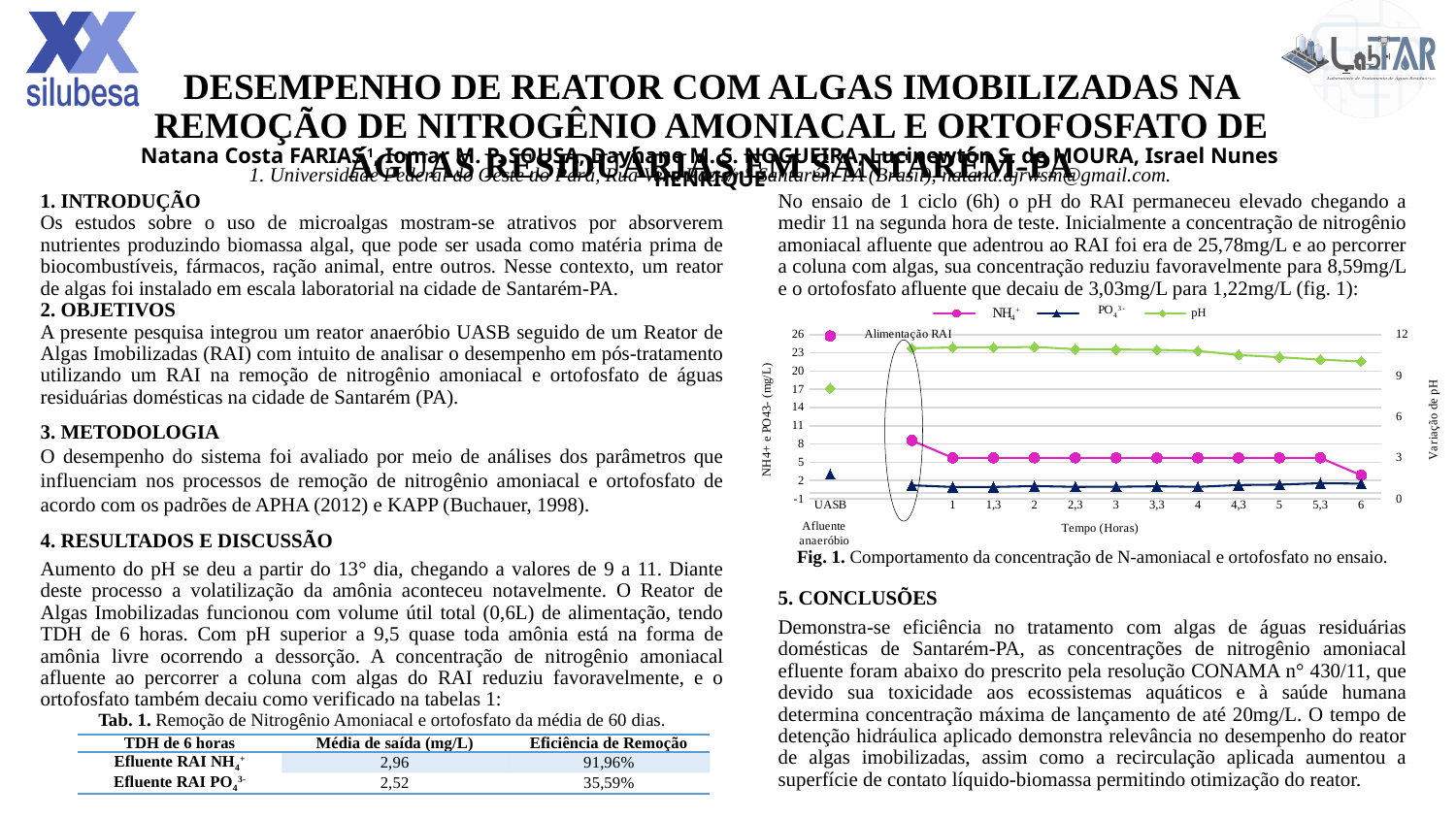
In Fig. 1, at hour 3, which is larger: NH4+ or PO4 3-? NH4+ In Fig. 1, at which point on the x axis is the NH4+ series at its lowest? 6 In Fig. 1, does the NH4+ series rise or fall from the UASB point to hour 6? fall What is the label of the x axis in Fig. 1? Tempo (Horas) What is the label of the right-hand vertical axis in Fig. 1? Variação de pH What kind of chart is Fig. 1? line chart In Fig. 1, is the NH4+ value at hour 6 greater or less than 5? less In Fig. 1, is the pH value at hour 6 greater or less than 9 on the right axis? greater How many series does the legend of Fig. 1 list? 3 In Fig. 1, which series has the highest value at the UASB point? NH4+ In Fig. 1, is the PO4 3- value at the UASB point greater or less than 5? less